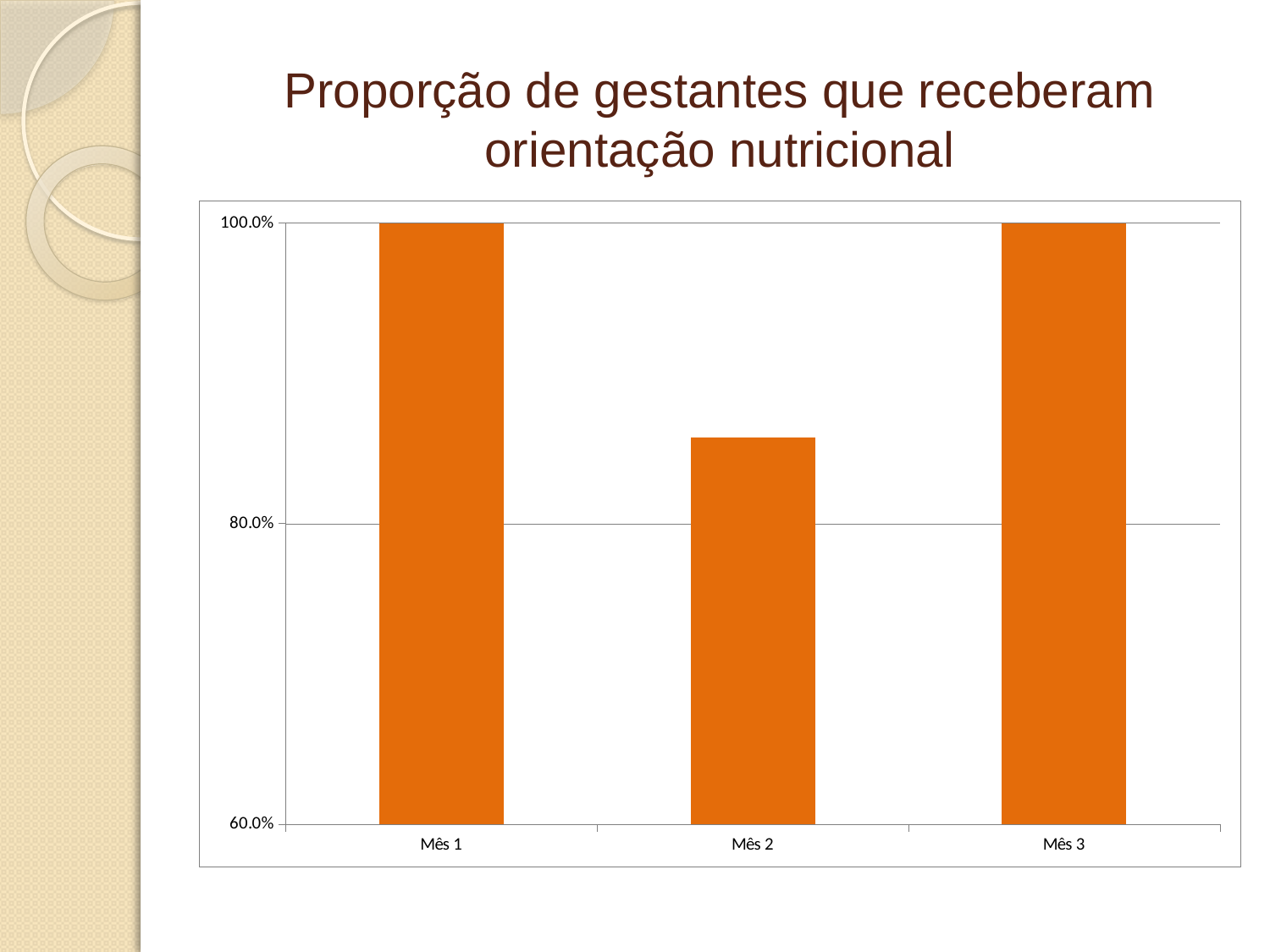
What kind of chart is shown on the slide? bar chart What colour are the bars in the chart? orange Which is larger, the value for Mês 1 or the value for Mês 2? Mês 1 How many months are shown on the x axis? 3 What is the title of the chart? Proporção de gestantes que receberam orientação nutricional What is the value for Mês 1? 100.0% Which month has the lowest value? Mês 2 What is the value for Mês 3? 100.0% Do the values rise or fall from Mês 1 to Mês 2? fall Is the value for Mês 2 greater or less than 80.0%? greater Is the value for Mês 2 greater or less than 100.0%? less Which is larger, the value for Mês 2 or the value for Mês 3? Mês 3